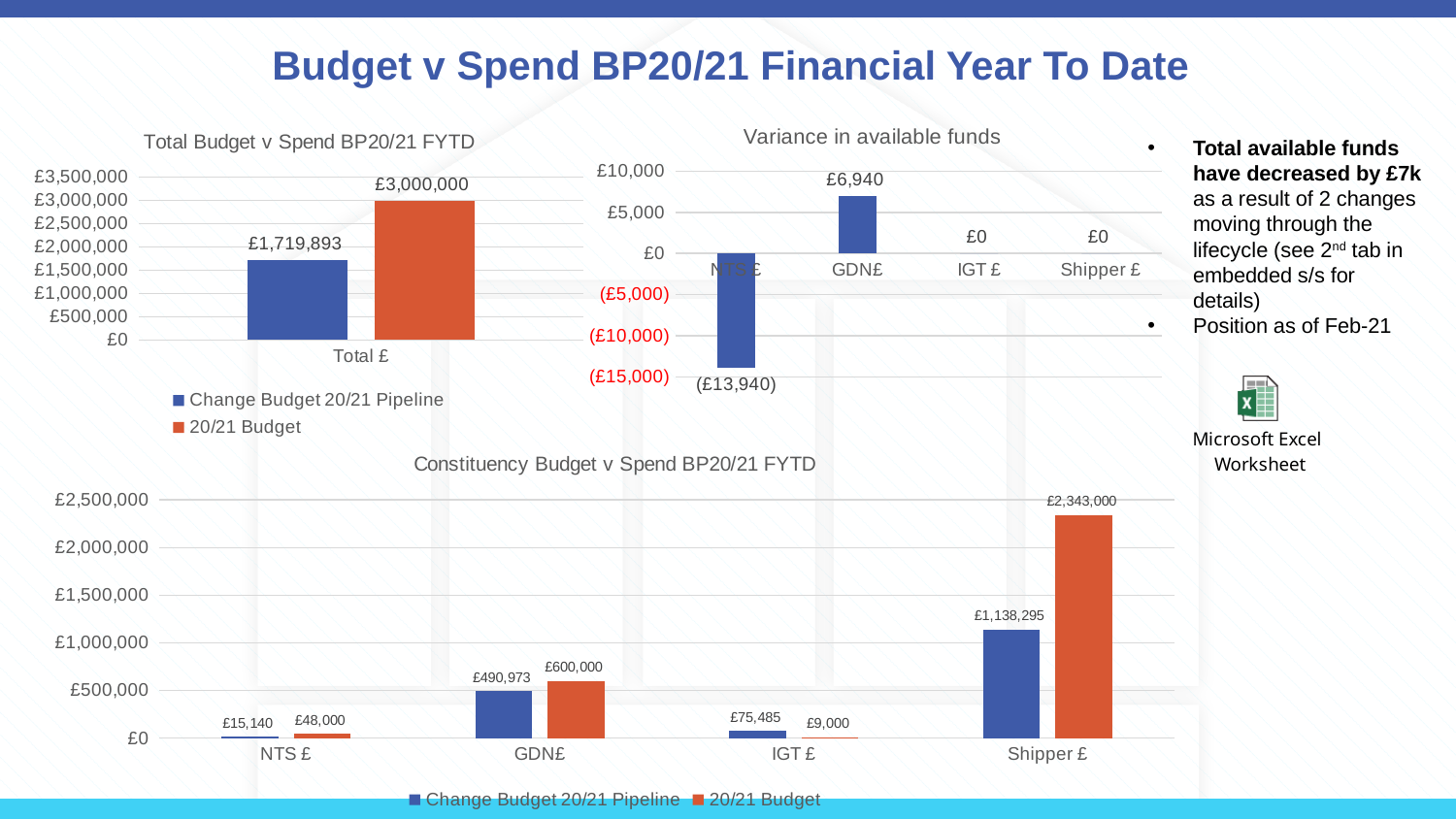
In the 'Variance in available funds' chart, how many categories are shown on the x axis? 4 In the 'Total Budget v Spend BP20/21 FYTD' chart, what is the value of the 20/21 Budget bar? £3,000,000 How many series does the legend of the 'Constituency Budget v Spend BP20/21 FYTD' chart list? 2 In the 'Variance in available funds' chart, what is the value for GDN£? £6,940 In the 'Variance in available funds' chart, what is the value for NTS £? (£13,940) In the 'Constituency Budget v Spend BP20/21 FYTD' chart, what is the 20/21 Budget value for GDN£? £600,000 In the 'Total Budget v Spend BP20/21 FYTD' chart, what is the value of the Change Budget 20/21 Pipeline bar for Total £? £1,719,893 In the 'Variance in available funds' chart, which category has the highest value? GDN£ In the 'Constituency Budget v Spend BP20/21 FYTD' chart, which category has the highest 20/21 Budget value? Shipper £ In the 'Constituency Budget v Spend BP20/21 FYTD' chart, what is the Change Budget 20/21 Pipeline value for Shipper £? £1,138,295 In the 'Total Budget v Spend BP20/21 FYTD' chart, what is the difference between the 20/21 Budget and the Change Budget 20/21 Pipeline values? £1,280,107 In the 'Constituency Budget v Spend BP20/21 FYTD' chart, which is larger for IGT £: the Change Budget 20/21 Pipeline value or the 20/21 Budget value? Change Budget 20/21 Pipeline